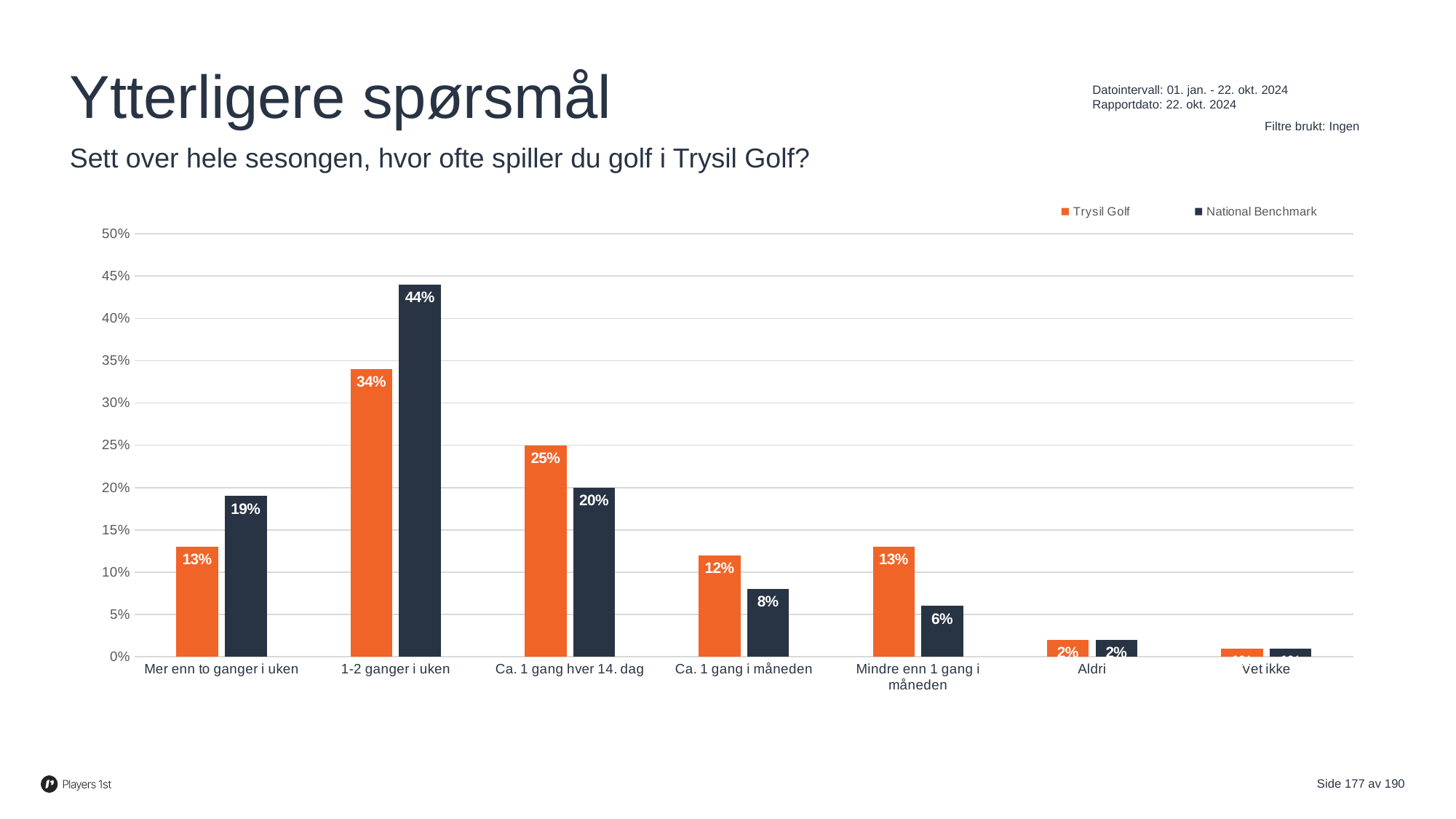
For "Ca. 1 gang hver 14. dag", which is larger: Trysil Golf or National Benchmark? Trysil Golf What is the Trysil Golf value for "Ca. 1 gang hver 14. dag"? 25% What is the National Benchmark value for "Mindre enn 1 gang i måneden"? 6% What is the difference between the Trysil Golf and National Benchmark values for "Ca. 1 gang i måneden"? 4% Which category has the highest National Benchmark value? 1-2 ganger i uken What is the National Benchmark value for "Mer enn to ganger i uken"? 19% What kind of chart is shown on the slide? Bar chart What is the difference between the National Benchmark and Trysil Golf values for "1-2 ganger i uken"? 10% Which category has the highest Trysil Golf value? 1-2 ganger i uken What is the Trysil Golf value for "1-2 ganger i uken"? 34% How many series does the legend list? 2 How many categories are shown on the x axis? 7